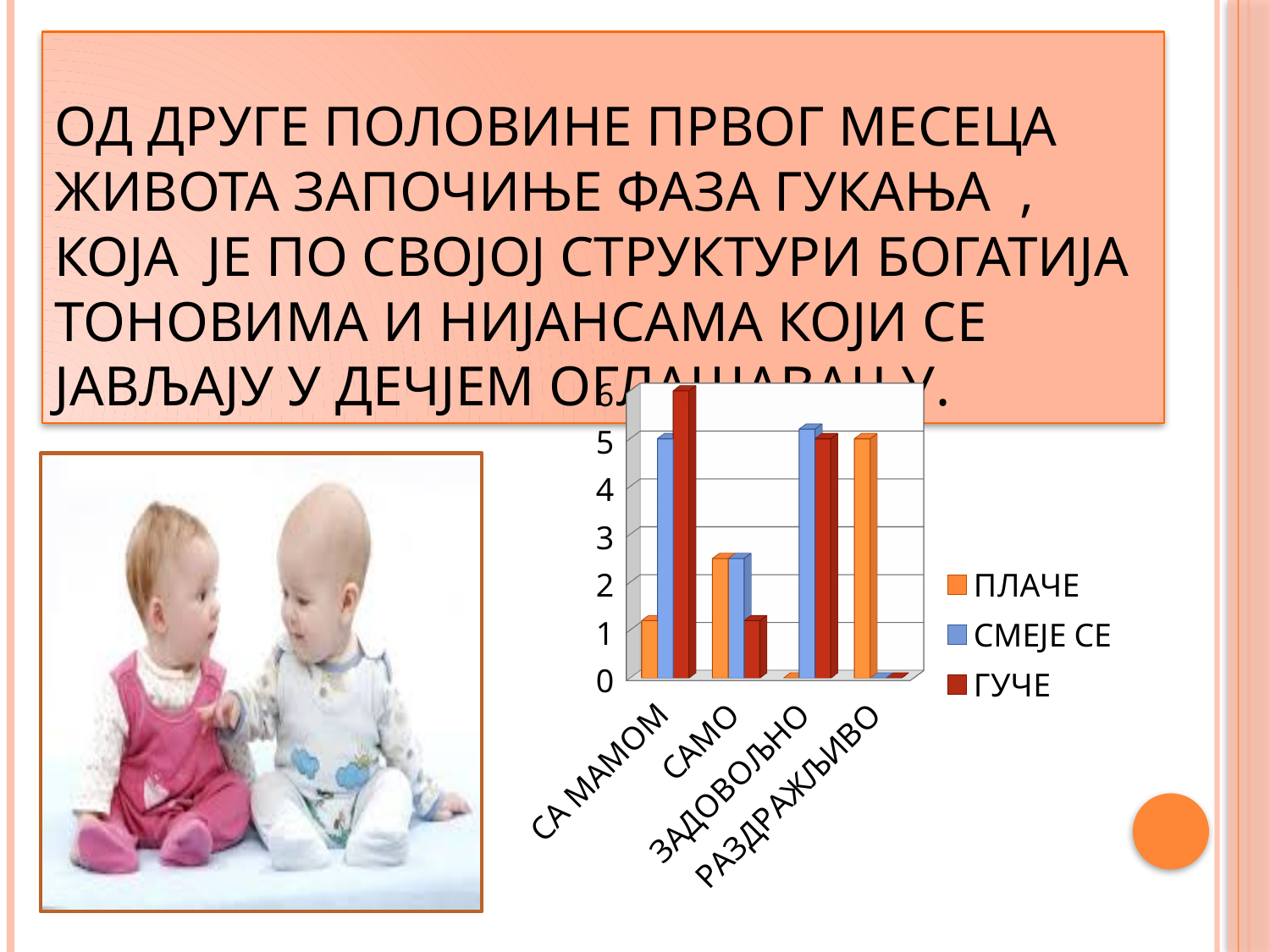
How many series does the chart legend list? 3 Is the value of ГУЧЕ for СА МАМОМ greater or less than 4? greater How many categories are shown on the x axis of the chart? 4 What kind of chart is shown on the slide? bar chart Is the value of ГУЧЕ for САМО greater or less than 2? less For which category is the ПЛАЧЕ value highest? РАЗДРАЖЉИВО Which series is shown in orange in the chart legend? ПЛАЧЕ Which is larger for СА МАМОМ: ПЛАЧЕ or СМЕЈЕ СЕ? СМЕЈЕ СЕ Is the value of ПЛАЧЕ for СА МАМОМ greater or less than 2? less Which series is shown in dark red in the chart legend? ГУЧЕ Which is larger for САМО: ПЛАЧЕ or ГУЧЕ? ПЛАЧЕ